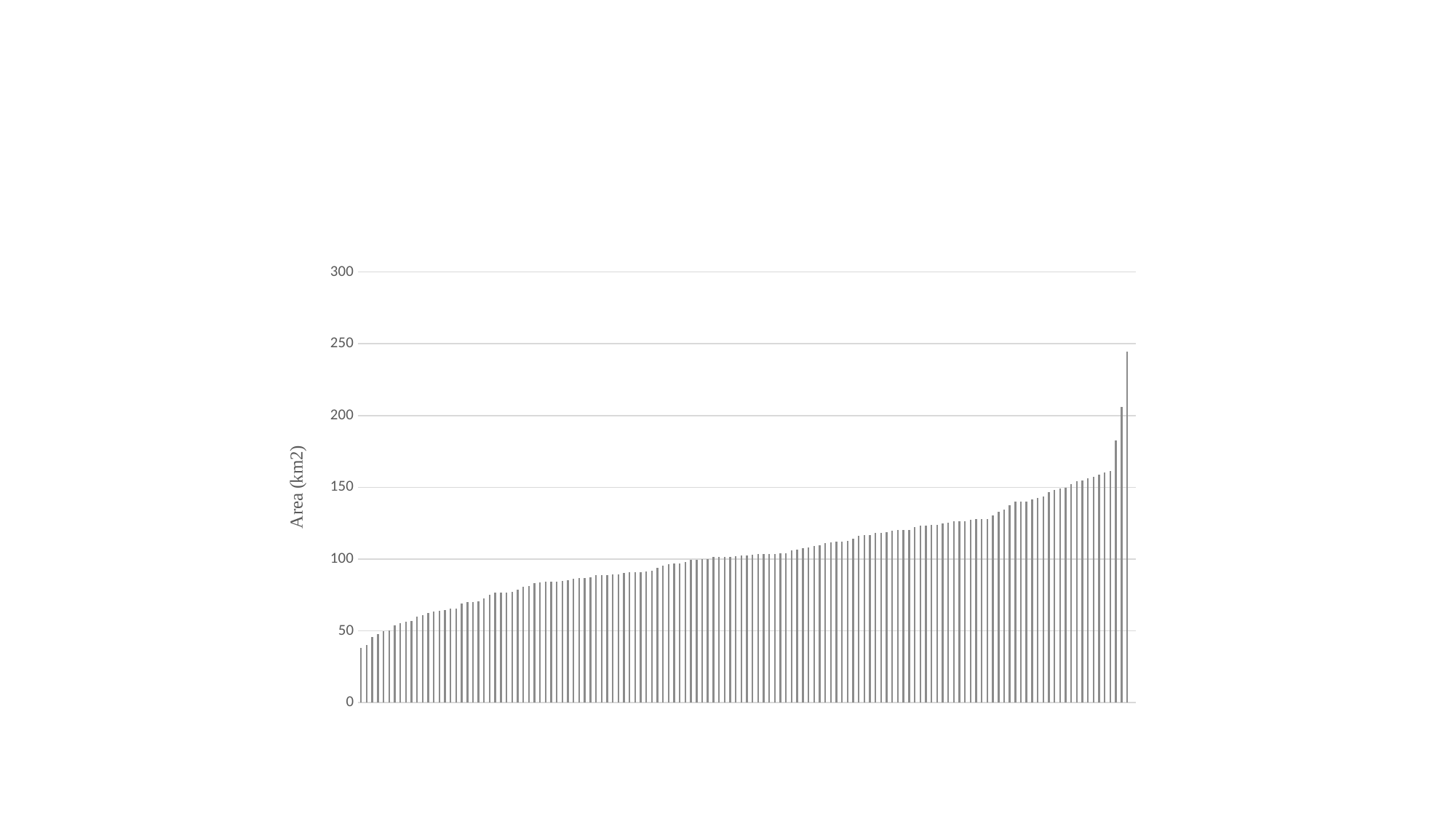
Is the value of the tallest bar greater or less than 200? greater Where on the chart is the tallest bar located? at the far right Which bar is taller, the leftmost bar or the rightmost bar? the rightmost bar What is the label on the vertical axis of the chart? Area (km2) Is the value of the tallest bar greater or less than 250? less Is the value of the third-tallest bar greater or less than 150? greater Does the chart display a legend? No Where on the chart is the shortest bar located? at the far left Do the bar values rise or fall from left to right along the x axis? rise What kind of chart is shown on the slide? bar chart